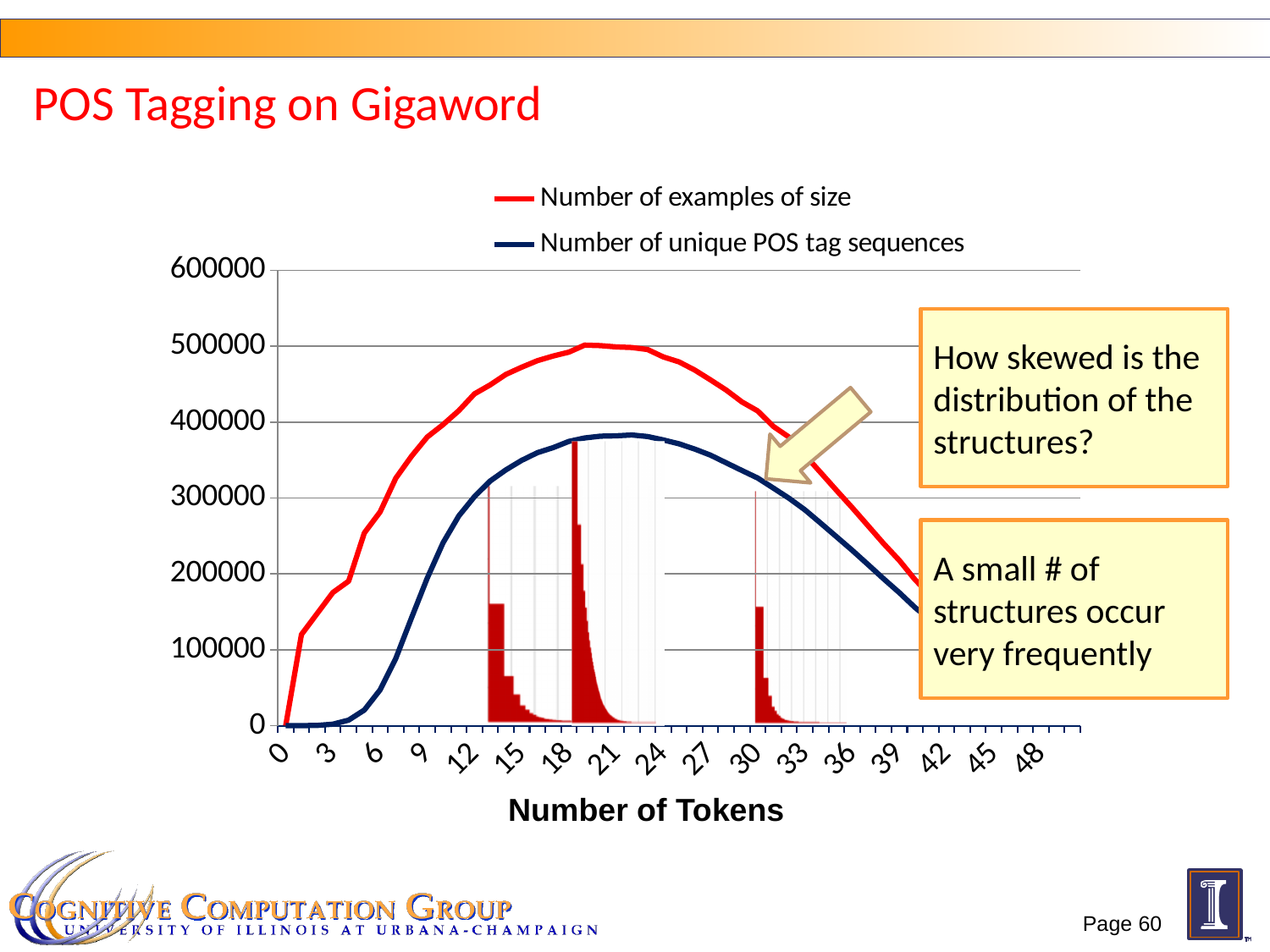
How many series does the legend list? 2 Is the value of Number of unique POS tag sequences at 6 tokens greater or less than 100000? less Which series is drawn in red? Number of examples of size Between 27 and 42 tokens, does the Number of unique POS tag sequences series rise or fall? fall Which series reaches the higher peak, Number of examples of size or Number of unique POS tag sequences? Number of examples of size Is the value of Number of unique POS tag sequences at 42 tokens greater or less than 200000? less Is the value of Number of examples of size at 6 tokens greater or less than 200000? greater What kind of chart is shown on the slide? line chart Between 0 and 18 tokens, does the Number of examples of size series rise or fall? rise What is the title of the x axis? Number of Tokens What is the highest value labelled on the y axis? 600000